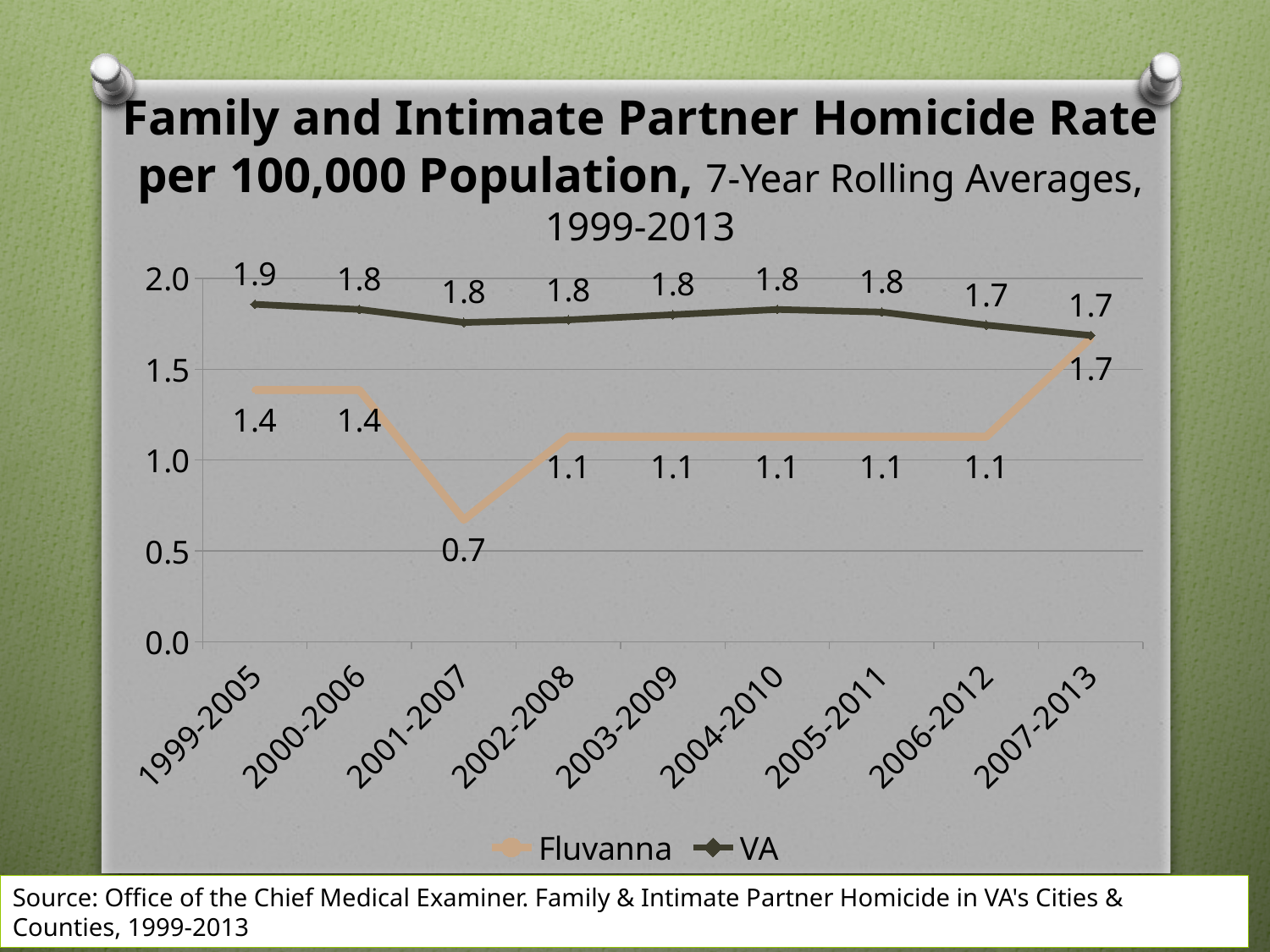
What is the VA value for 1999-2005? 1.9 What is the difference between the VA and Fluvanna values for 2001-2007? 1.1 How many time periods are plotted along the x axis? 9 What is the Fluvanna value for 2001-2007? 0.7 What is the Fluvanna value for 2007-2013? 1.7 Which series has the larger value for 2003-2009, Fluvanna or VA? VA Is the Fluvanna value for 2001-2007 greater or less than 1.0? less How many series does the legend list? 2 What type of chart is shown on the slide? Line chart In which period is the Fluvanna value lowest? 2001-2007 In which period is the VA value highest? 1999-2005 Which series is drawn in the lighter, tan-coloured line? Fluvanna